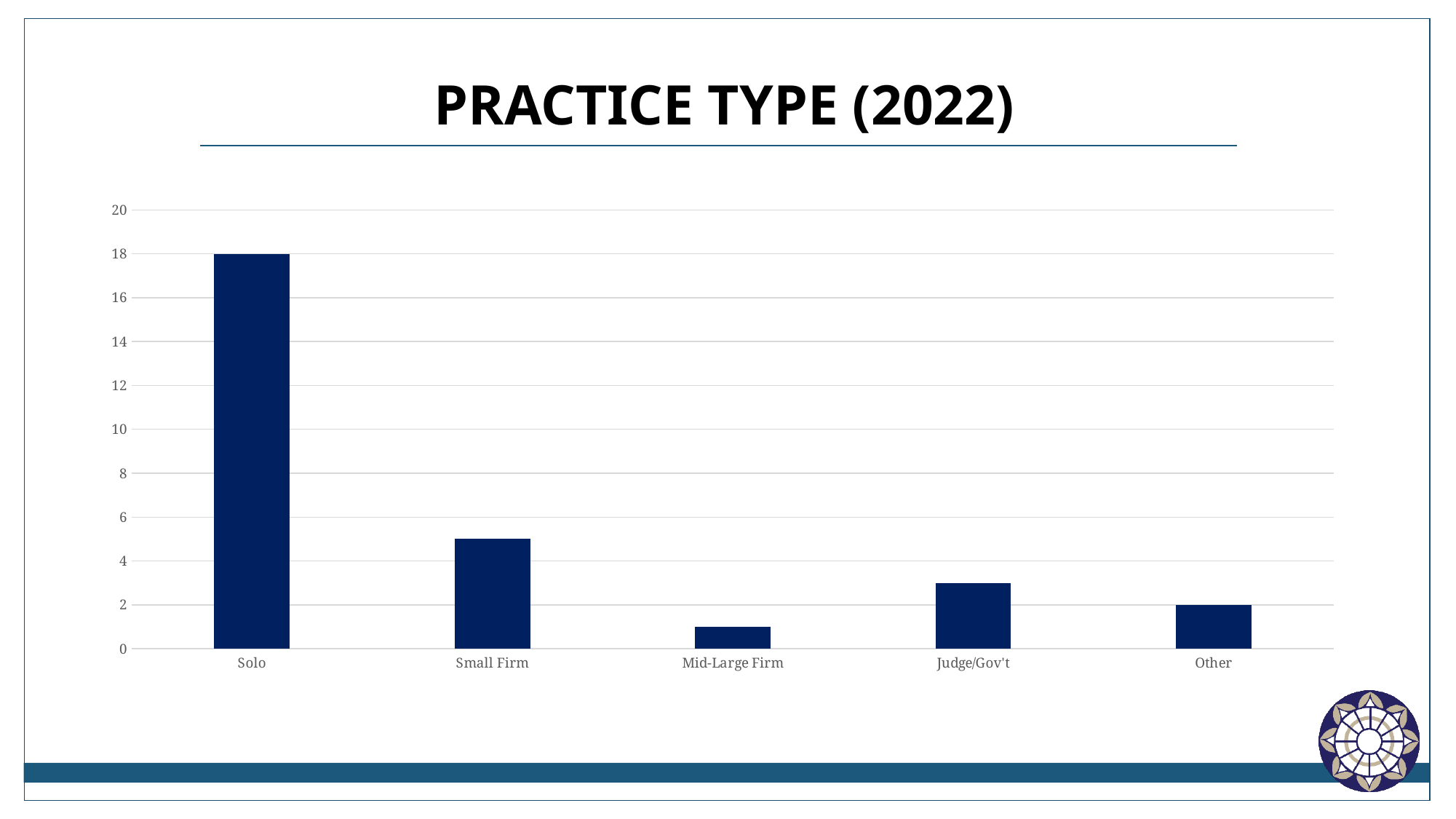
Is the value for Mid-Large Firm greater or less than 2? less What is the difference between the values for Solo and Other? 16 How many practice type categories are shown on the chart? 5 Which practice type has the lowest value? Mid-Large Firm What is the value for Solo? 18 Which practice type has the highest value? Solo Is the value for Small Firm greater or less than 4? greater What is the title of the slide? PRACTICE TYPE (2022) What kind of chart is shown on the slide? Bar chart Is the value for Judge/Gov't greater or less than 4? less Which is larger, the value for Small Firm or the value for Judge/Gov't? Small Firm What is the value for Other? 2